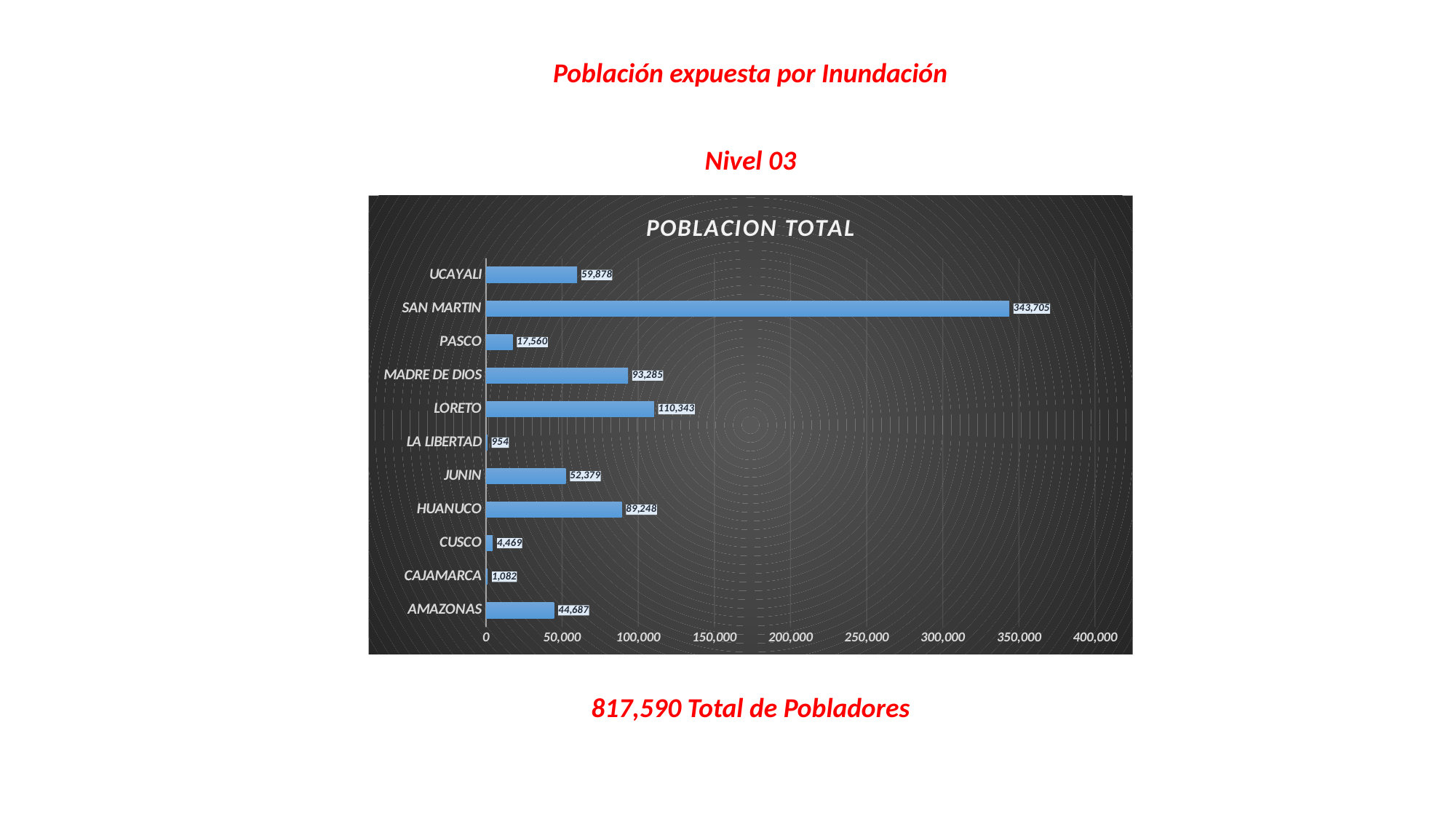
What is the value for CAJAMARCA? 1,082 Which category has the lowest value? LA LIBERTAD What is the value for LORETO? 110,343 Which is larger, the value for HUANUCO or the value for JUNIN? HUANUCO What is the difference between the values for LORETO and MADRE DE DIOS? 17,058 What kind of chart is shown? bar chart Which category has the highest value? SAN MARTIN How many categories are shown in the chart? 11 What is the value for SAN MARTIN? 343,705 Is the value for SAN MARTIN greater or less than 300,000? greater What is the value for PASCO? 17,560 What is the title of the chart? POBLACION TOTAL